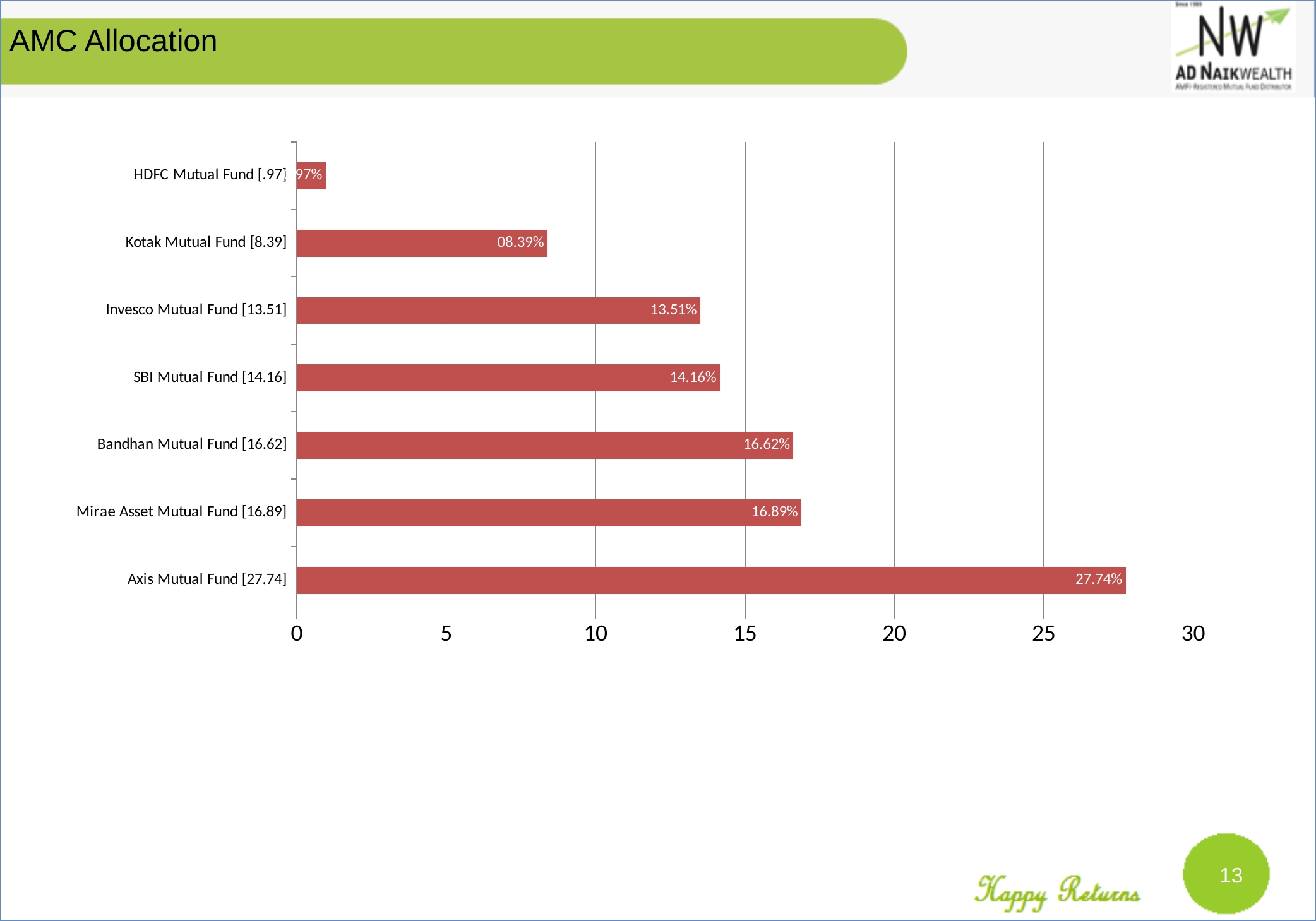
Which is larger, the value for Invesco Mutual Fund or SBI Mutual Fund? SBI Mutual Fund What is the value for Bandhan Mutual Fund? 16.62% How many funds are shown in the chart? 7 Is the value for Kotak Mutual Fund greater or less than 10? less What is the title of the slide? AMC Allocation What is the value for Axis Mutual Fund? 27.74% What is the value for Kotak Mutual Fund? 08.39% What kind of chart is shown on the slide? Bar chart What is the value for SBI Mutual Fund? 14.16% Which fund has the highest allocation? Axis Mutual Fund What is the difference between the values for Axis Mutual Fund and Mirae Asset Mutual Fund? 10.85 Which fund has the lowest allocation? HDFC Mutual Fund